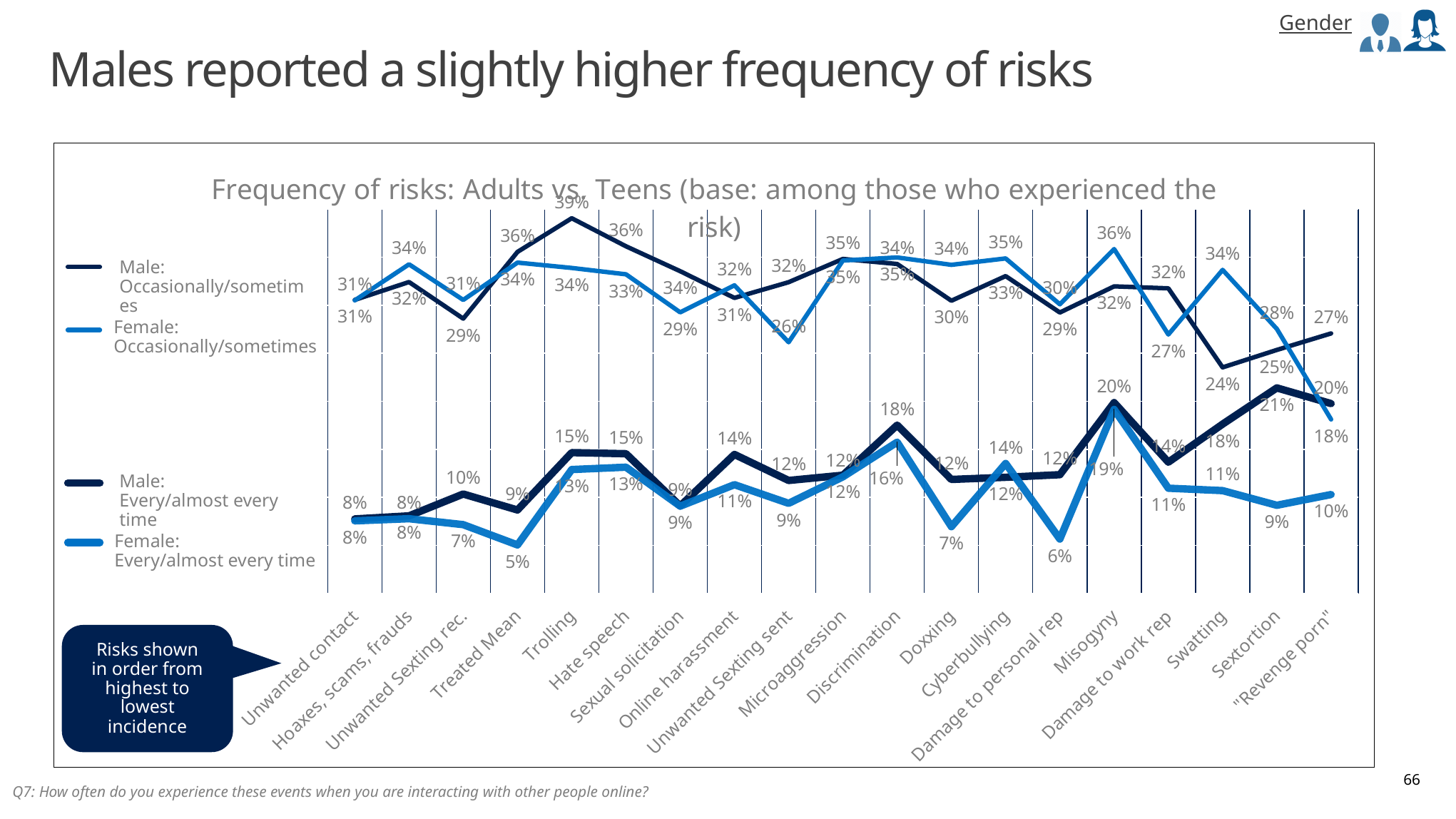
For which risk is the Male: Occasionally/sometimes value highest? Trolling What is the value for Male: Occasionally/sometimes at Trolling? 39% What is the value for Female: Every/almost every time at Treated Mean? 5% At Trolling, what is the difference between Male: Occasionally/sometimes and Female: Occasionally/sometimes? 5 percentage points For which risk is the Female: Every/almost every time value lowest? Treated Mean What is the value for Female: Occasionally/sometimes at Misogyny? 36% How many risk categories are plotted along the x axis? 19 How many series does the legend list? 4 At Swatting, which is larger: Male: Occasionally/sometimes or Female: Occasionally/sometimes? Female: Occasionally/sometimes For which risk is the Female: Every/almost every time value highest? Misogyny What is the value for Male: Every/almost every time at Sextortion? 21% What kind of chart is shown on the slide? Line chart